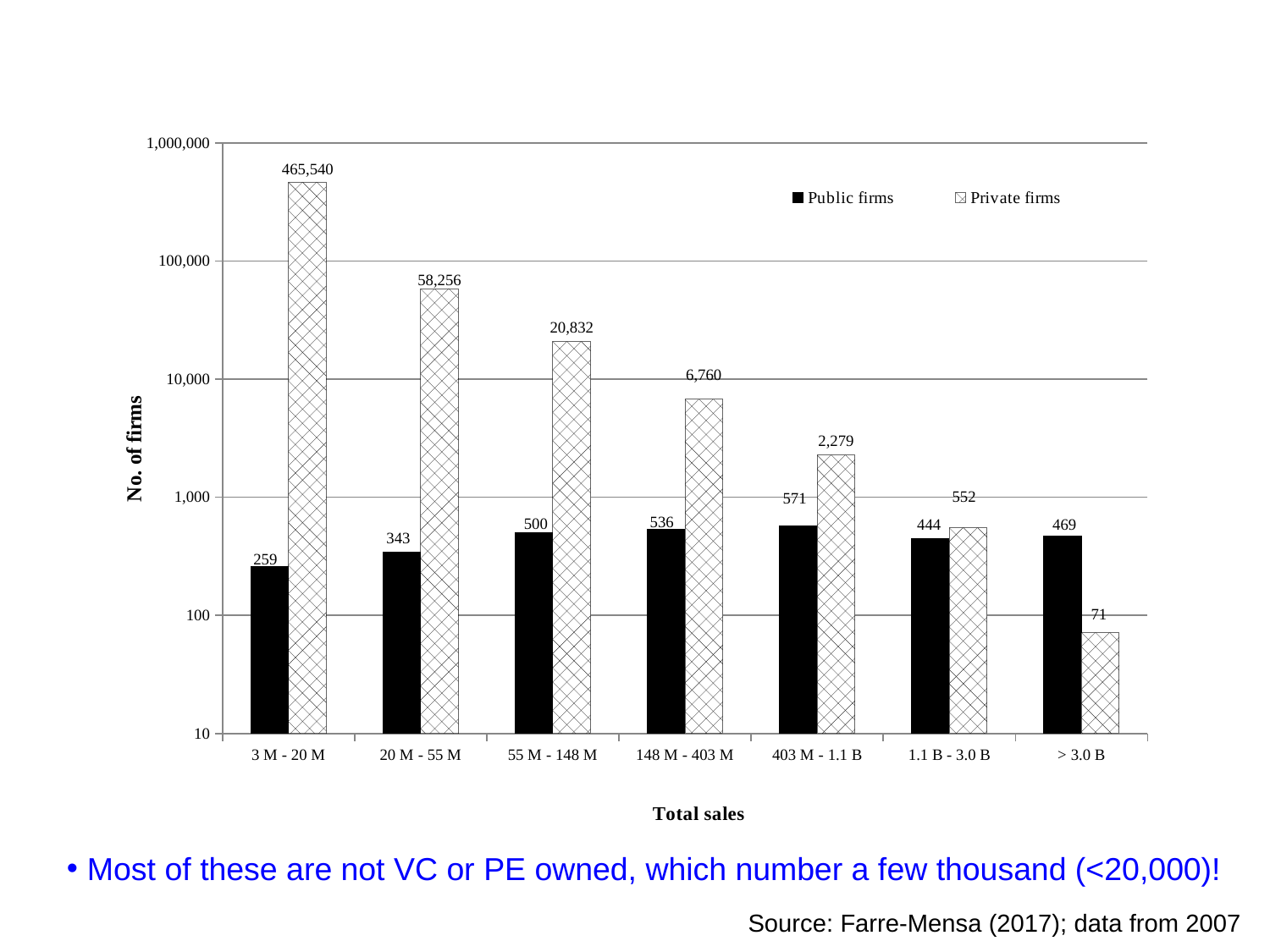
How many total sales categories are shown on the x axis? 7 How many public firms are in the 403 M - 1.1 B total sales category? 571 Is the number of private firms in the 148 M - 403 M category greater or less than 1,000? greater What kind of chart is shown on the slide? Bar chart How many series does the legend list? 2 Which total sales category has the highest number of public firms? 403 M - 1.1 B What is the difference between the number of private firms and public firms in the 20 M - 55 M category? 57,913 Do the private firm values rise or fall as total sales increase along the x axis? Fall How many private firms are in the 3 M - 20 M total sales category? 465,540 How many private firms have total sales greater than 3.0 B? 71 In the > 3.0 B category, are there more public firms or private firms? Public firms Which total sales category has the lowest number of private firms? > 3.0 B